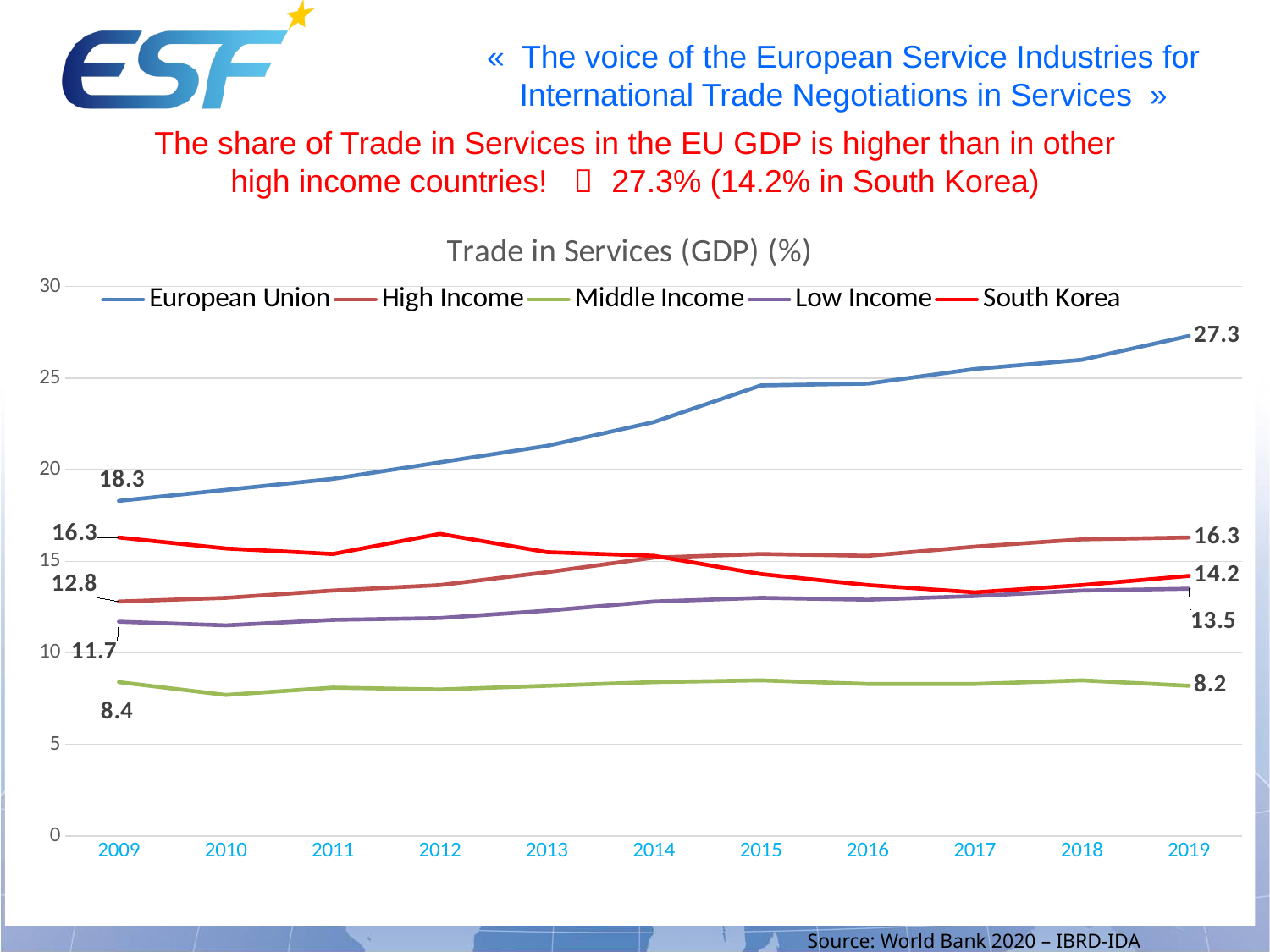
Is the value for the European Union in 2015 greater or less than 20? greater By how much did the European Union value increase from 2009 to 2019? 9 Which is larger in 2019, High Income or South Korea? High Income What is the value for Low Income in 2009? 11.7 What kind of chart is shown on the slide? Line chart How many years are shown on the x axis? 11 What is the value for the European Union in 2009? 18.3 What is the value for South Korea in 2019? 14.2 Which series has the highest value in 2019? European Union Which series has the lowest value in 2009? Middle Income How many series does the legend list? 5 What is the value for the European Union in 2019? 27.3